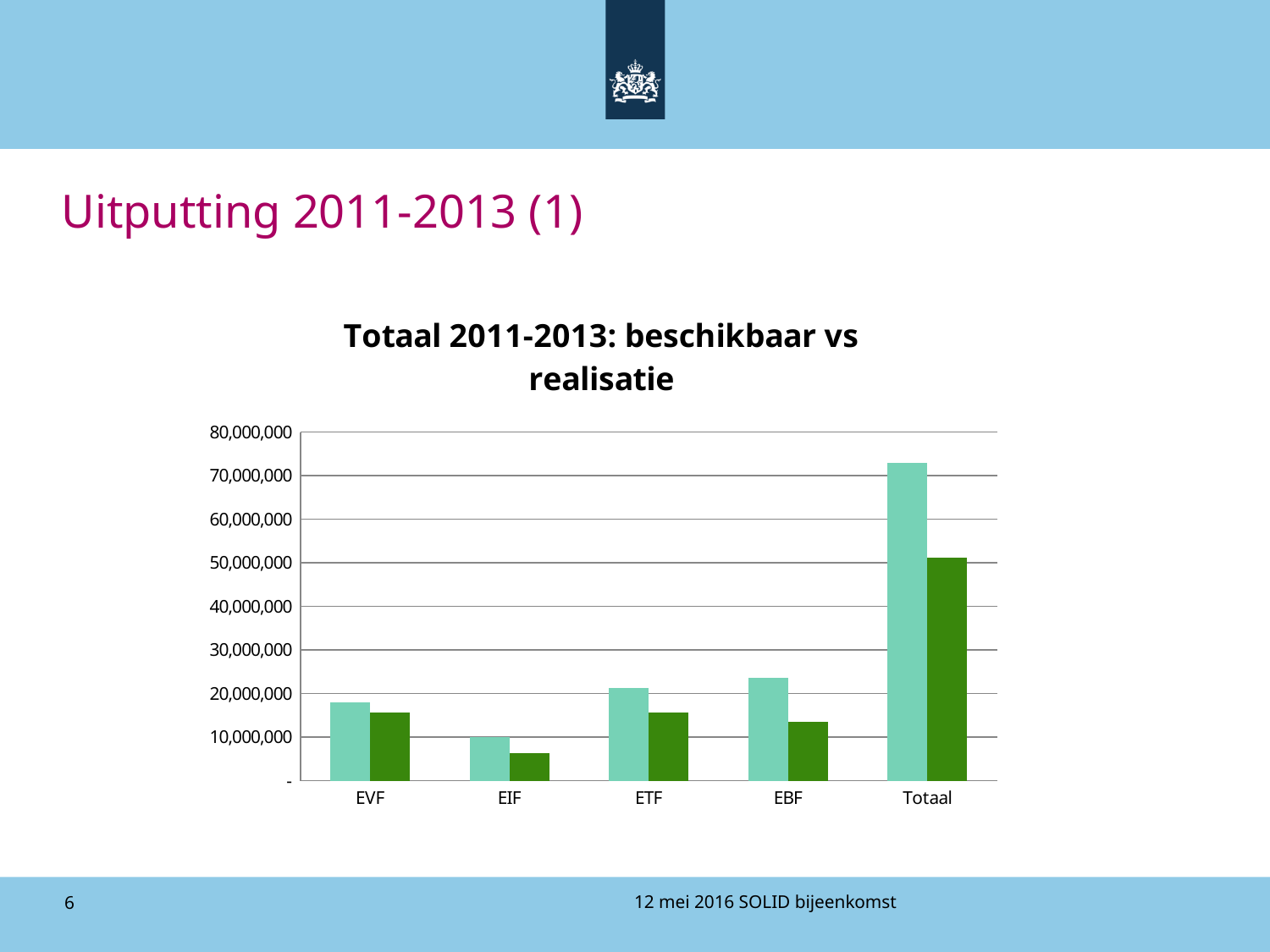
Is the dark green bar for EIF greater or less than 10,000,000? less Which has the larger dark green bar, EVF or EIF? EVF What kind of chart is shown on the slide? Bar chart What is the title of the chart? Totaal 2011-2013: beschikbaar vs realisatie Is the light teal bar for EBF greater or less than 20,000,000? greater Which category has the shortest dark green bar? EIF Which category has the tallest light teal bar? Totaal Which category has the shortest light teal bar? EIF Which has the larger light teal bar, EVF or EBF? EBF Is the light teal bar for Totaal greater or less than 70,000,000? greater How many categories are shown on the x axis of the chart? 5